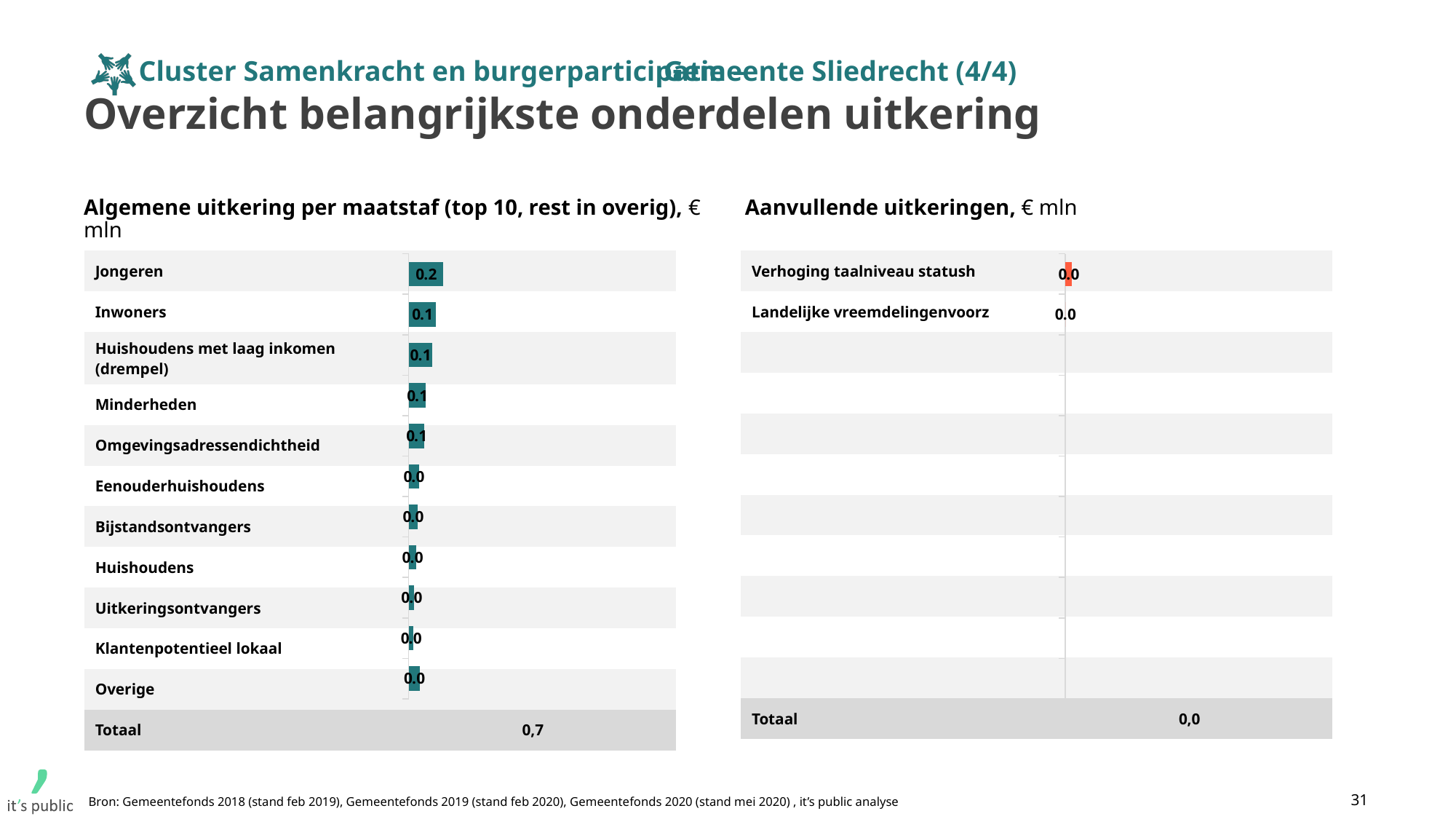
In the chart 'Algemene uitkering per maatstaf', what is the difference between the values for Jongeren and Inwoners? 0.1 What kind of chart is 'Algemene uitkering per maatstaf'? Bar chart In the chart 'Algemene uitkering per maatstaf', which category has the highest value? Jongeren In the chart 'Algemene uitkering per maatstaf', what is the value for Jongeren? 0.2 In the chart 'Algemene uitkering per maatstaf', what is the value for Inwoners? 0.1 How many categories are shown in the chart 'Algemene uitkering per maatstaf' (excluding the Totaal row)? 11 In the chart 'Algemene uitkering per maatstaf', which is larger, the value for Jongeren or the value for Huishoudens? Jongeren In the chart 'Aanvullende uitkeringen', what is the value for Landelijke vreemdelingenvoorz? 0.0 What is the Totaal shown for the chart 'Algemene uitkering per maatstaf'? 0,7 In the chart 'Algemene uitkering per maatstaf', what is the value for Bijstandsontvangers? 0.0 In the chart 'Algemene uitkering per maatstaf', what is the value for Minderheden? 0.1 How many categories are shown in the chart 'Aanvullende uitkeringen' (excluding the Totaal row)? 2